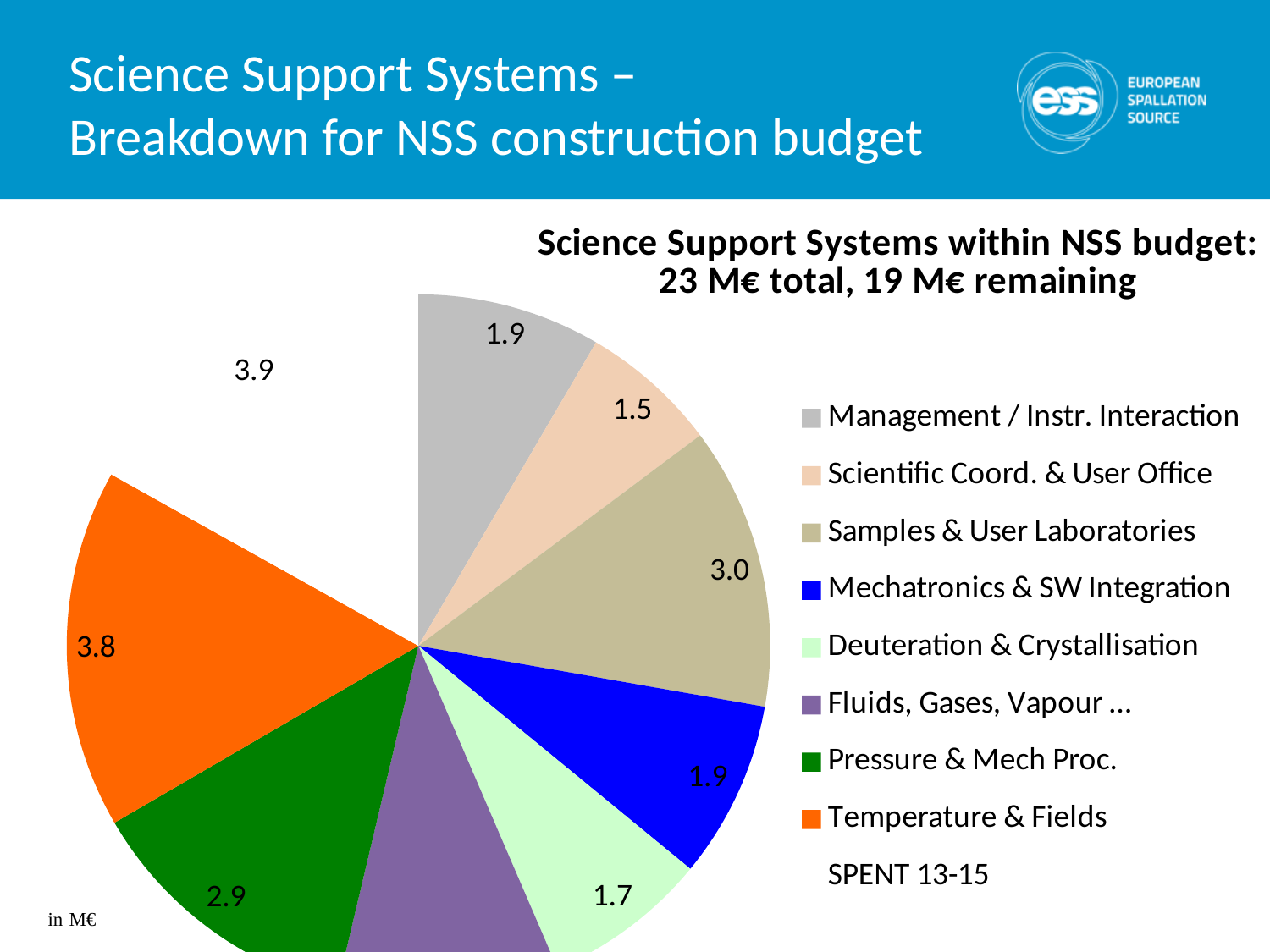
What is the value for Temperature & Fields? 3.8 What is the difference between Samples & User Laboratories and Scientific Coord. & User Office? 1.5 What is the value for Pressure & Mech Proc.? 2.9 Which is larger, Temperature & Fields or Samples & User Laboratories? Temperature & Fields How many entries does the legend list? 9 What is the value for Samples & User Laboratories? 3.0 According to the chart title, what is the total Science Support Systems budget within NSS? 23 M€ What is the value for Deuteration & Crystallisation? 1.7 What kind of chart is shown on the slide? pie chart What is the value for Scientific Coord. & User Office? 1.5 What is the value for Mechatronics & SW Integration? 1.9 Which category has the smallest slice of the pie? Scientific Coord. & User Office